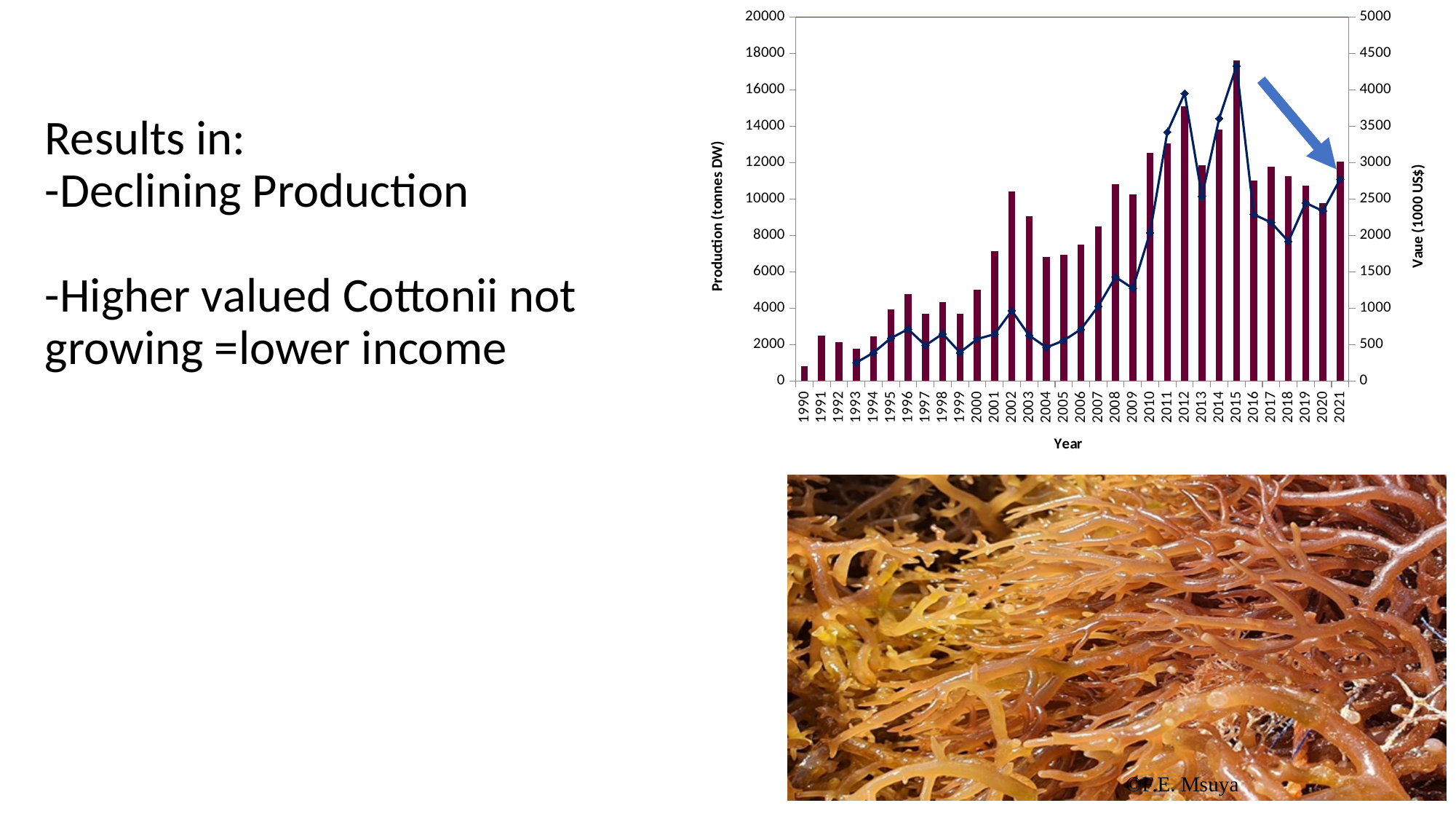
How many years are shown on the x axis of the chart? 32 Does the value line rise or fall from 2015 to 2018? Fall What is the label of the left vertical axis of the chart? Production (tonnes DW) Is the production bar for 2003 greater or less than 10000? less Is the production bar for 2015 greater or less than 16000? greater Which year has the shortest production bar? 1990 Is the value line point for 2015 greater or less than 4000 on the right axis? greater Which year has the tallest production bar? 2015 Which year has the higher production bar, 2015 or 2016? 2015 What kind of chart is shown on the slide? A bar chart combined with a line